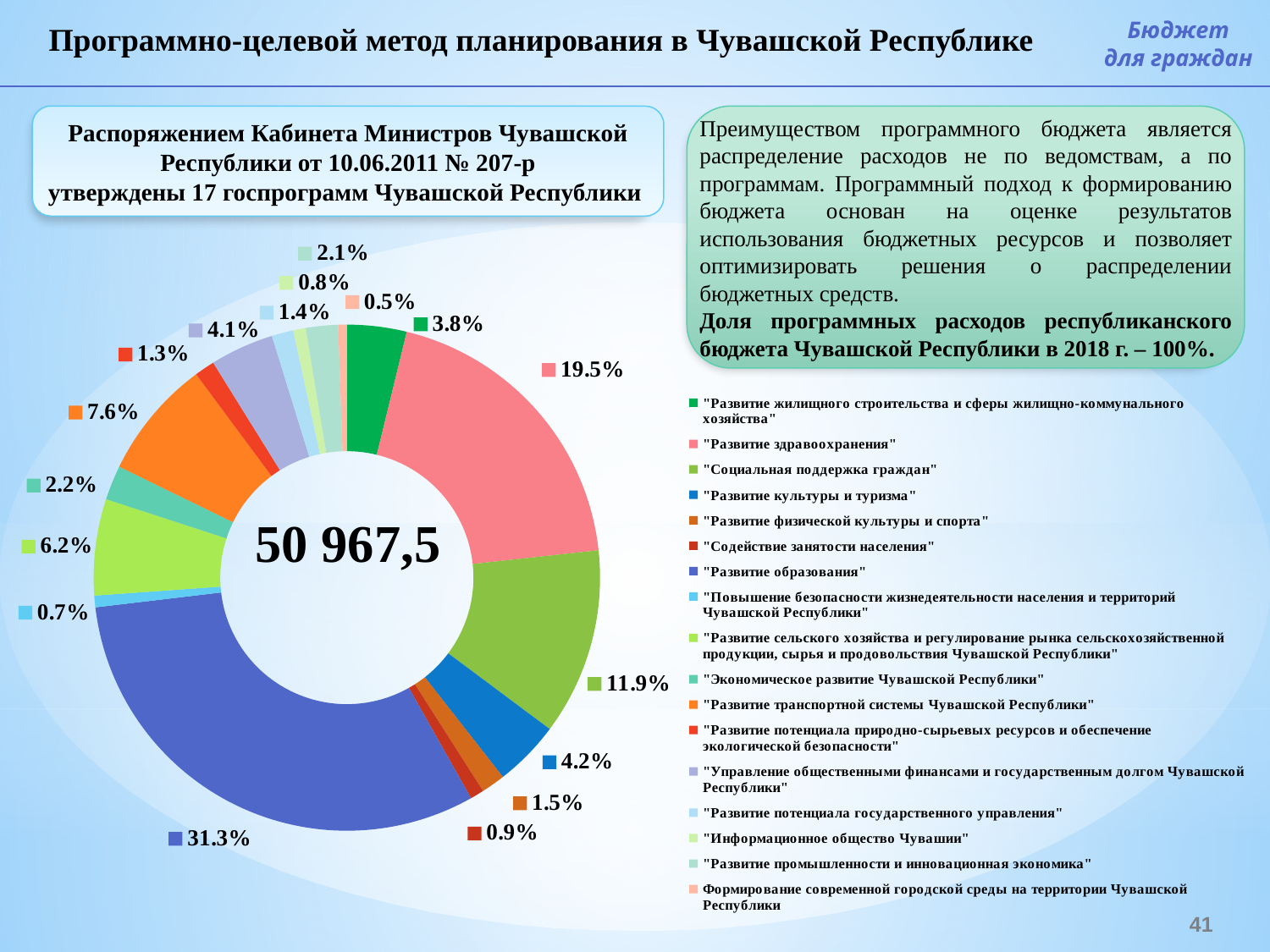
What is the smallest percentage labelled on the pie chart? 0.5% What percentage is shown for "Развитие транспортной системы Чувашской Республики" in the pie chart? 7.6% What percentage is shown for "Социальная поддержка граждан" in the pie chart? 11.9% What is the difference between the shares for "Развитие здравоохранения" (19.5%) and "Социальная поддержка граждан" (11.9%)? 7.6% How many entries does the legend of the chart list? 17 Which programme has the largest share in the pie chart? "Развитие образования" What share of the pie chart is labelled for "Развитие образования" (the largest slice)? 31.3% What percentage is shown for "Развитие здравоохранения" in the pie chart? 19.5% What value is printed in the centre of the doughnut chart? 50 967,5 What kind of chart is shown on the slide? Pie (doughnut) chart Which is larger: the share for "Развитие культуры и туризма" or the share for "Развитие сельского хозяйства и регулирование рынка сельскохозяйственной продукции, сырья и продовольствия Чувашской Республики"? "Развитие сельского хозяйства и регулирование рынка сельскохозяйственной продукции, сырья и продовольствия Чувашской Республики" How many slices (programmes) does the pie chart contain? 17